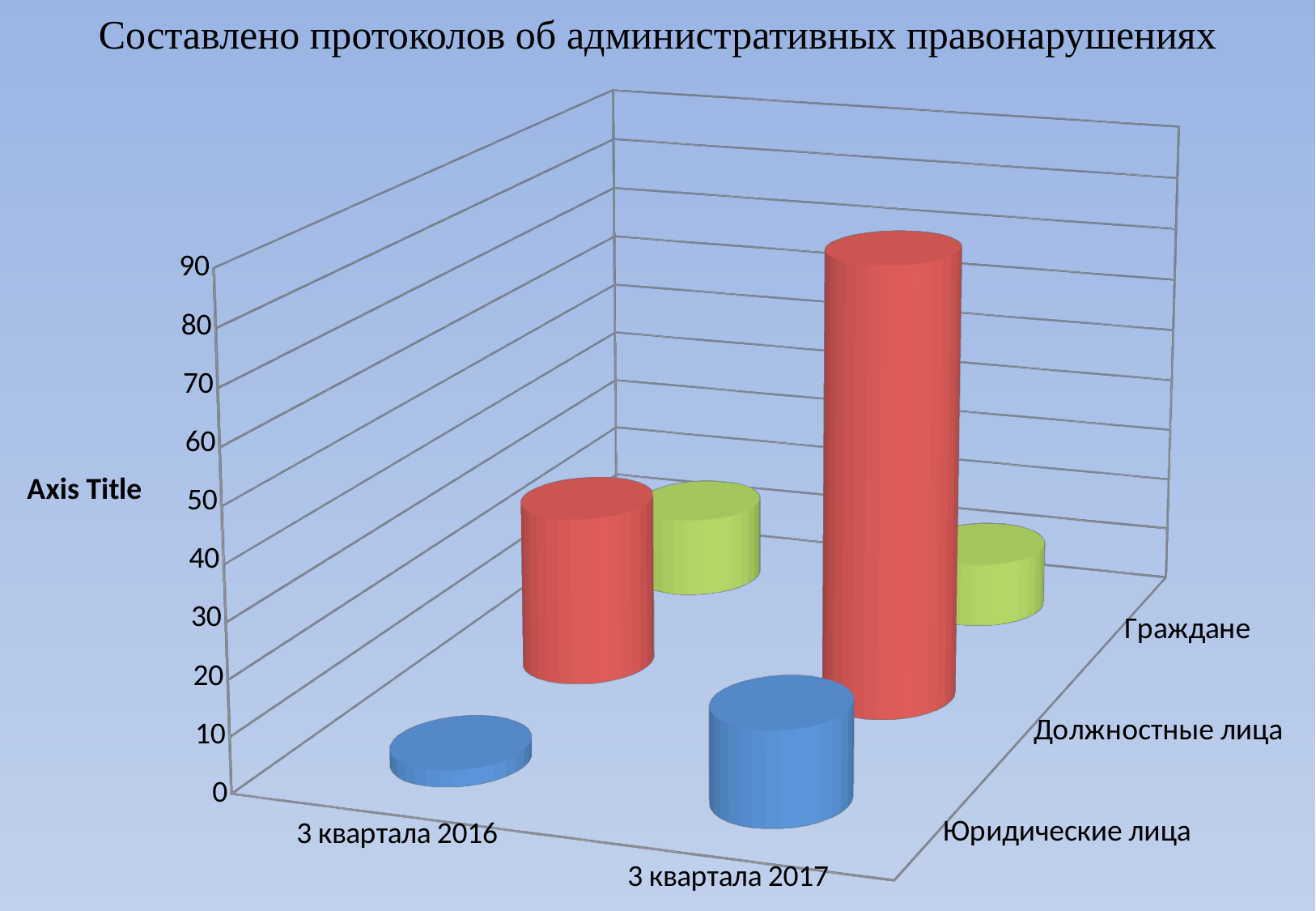
Is the value for Должностные лица in 3 квартала 2017 greater or less than 50? greater Which group has the lowest value for 3 квартала 2016? Юридические лица What kind of chart is shown on the slide? bar chart Does the value for Должностные лица rise or fall from 3 квартала 2016 to 3 квартала 2017? rise For Граждане, which period has the higher value: 3 квартала 2016 or 3 квартала 2017? 3 квартала 2016 Which group has the tallest bar in the whole chart? Должностные лица How many groups (series) are labelled along the depth axis of the chart? 3 For Должностные лица, which period has the higher value: 3 квартала 2016 or 3 квартала 2017? 3 квартала 2017 For Юридические лица, which period has the higher value: 3 квартала 2016 or 3 квартала 2017? 3 квартала 2017 Is the value for Юридические лица in 3 квартала 2016 greater or less than 10? less What is the title of the chart? Составлено протоколов об административных правонарушениях How many periods are shown along the horizontal axis? 2